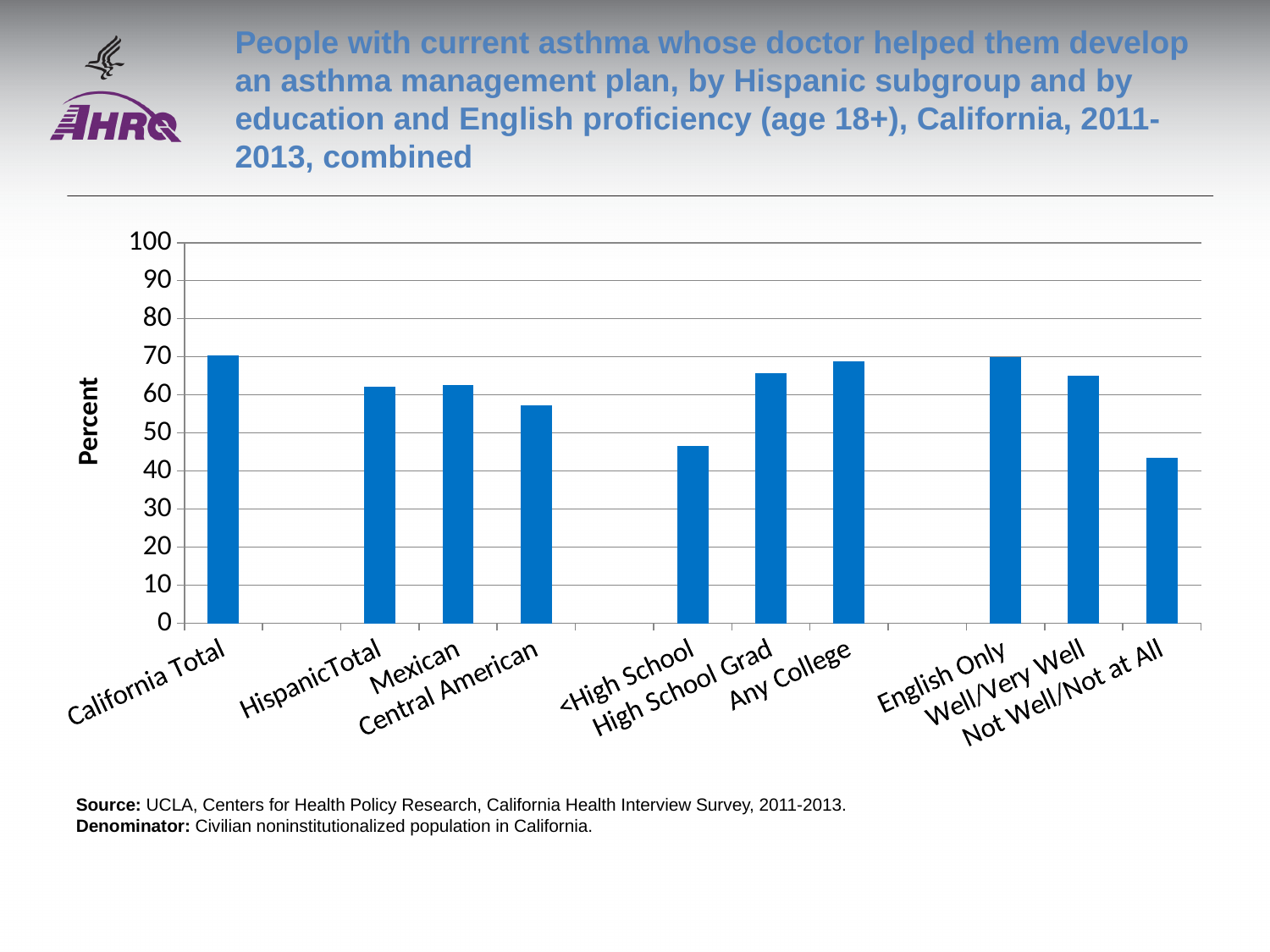
Is the value for <High School greater or less than 50? less Is the value for California Total greater or less than 60? greater Which is larger, the value for English Only or the value for Not Well/Not at All? English Only What is the label of the vertical axis? Percent Is the value for Not Well/Not at All greater or less than 50? less Which is larger, the value for Mexican or the value for Central American? Mexican How many categories (bars) are plotted on the chart? 10 What kind of chart is shown on the slide? bar chart Among the three education groups (<High School, High School Grad, Any College), which has the lowest value? <High School Which is larger, the value for Any College or the value for <High School? Any College